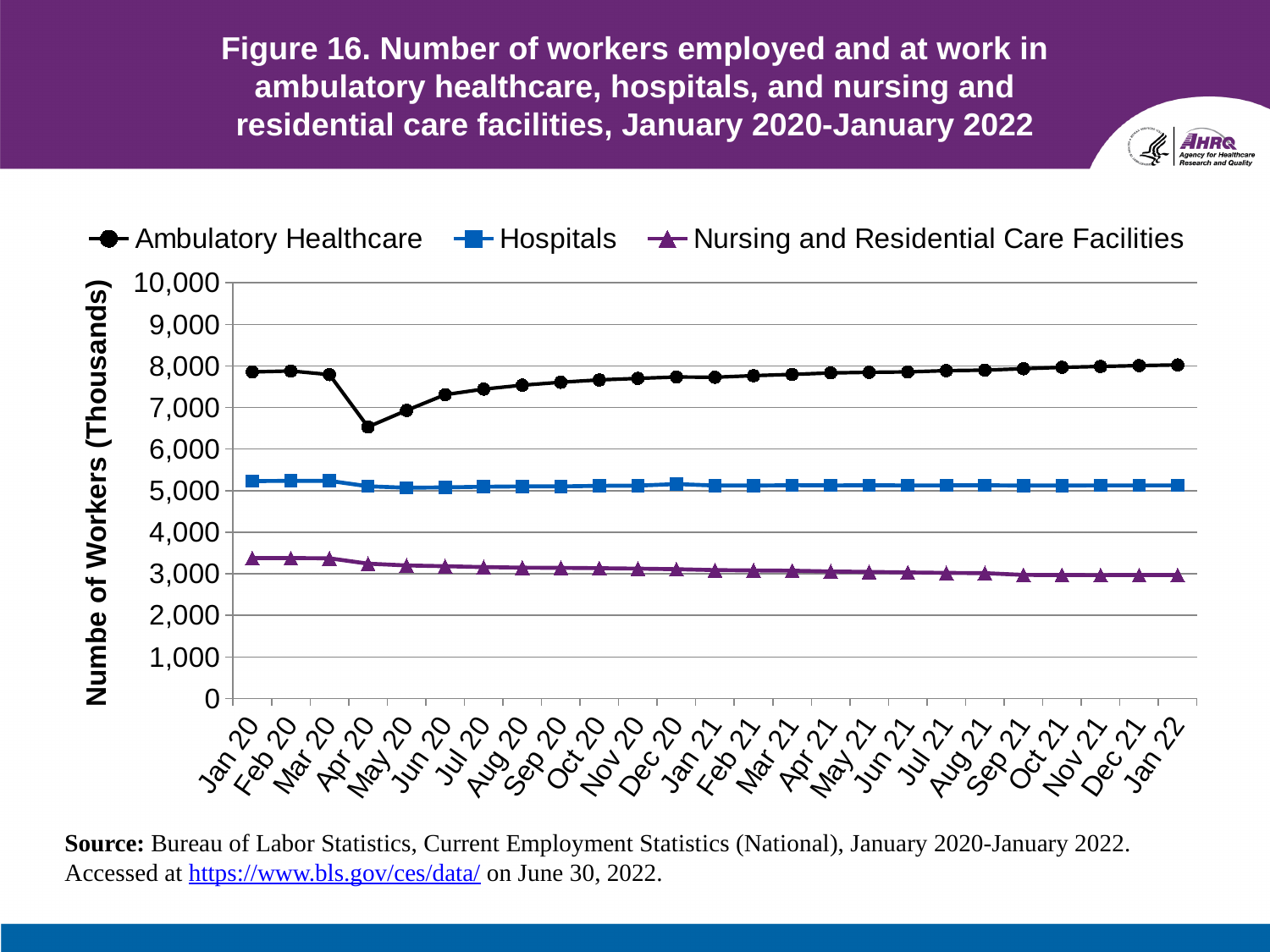
How many series does the legend list? 3 Which series has the highest values across the whole period? Ambulatory Healthcare Is the value for Nursing and Residential Care Facilities in Jan 22 greater or less than 4,000? less What kind of chart is shown on the slide? line chart How many monthly data points are plotted along the x axis for each series? 25 For Ambulatory Healthcare, which is larger: the value in Jan 20 or the value in Apr 20? Jan 20 In which month does the Ambulatory Healthcare series reach its lowest value? Apr 20 In Jan 22, which is larger: the value for Hospitals or the value for Nursing and Residential Care Facilities? Hospitals Is the value for Ambulatory Healthcare in Apr 20 greater or less than 7,000? less Do the values for Nursing and Residential Care Facilities rise or fall from Jan 20 to Jan 22? fall Is the value for Hospitals in Jan 20 greater or less than 5,000? greater Which series is plotted with triangle markers? Nursing and Residential Care Facilities